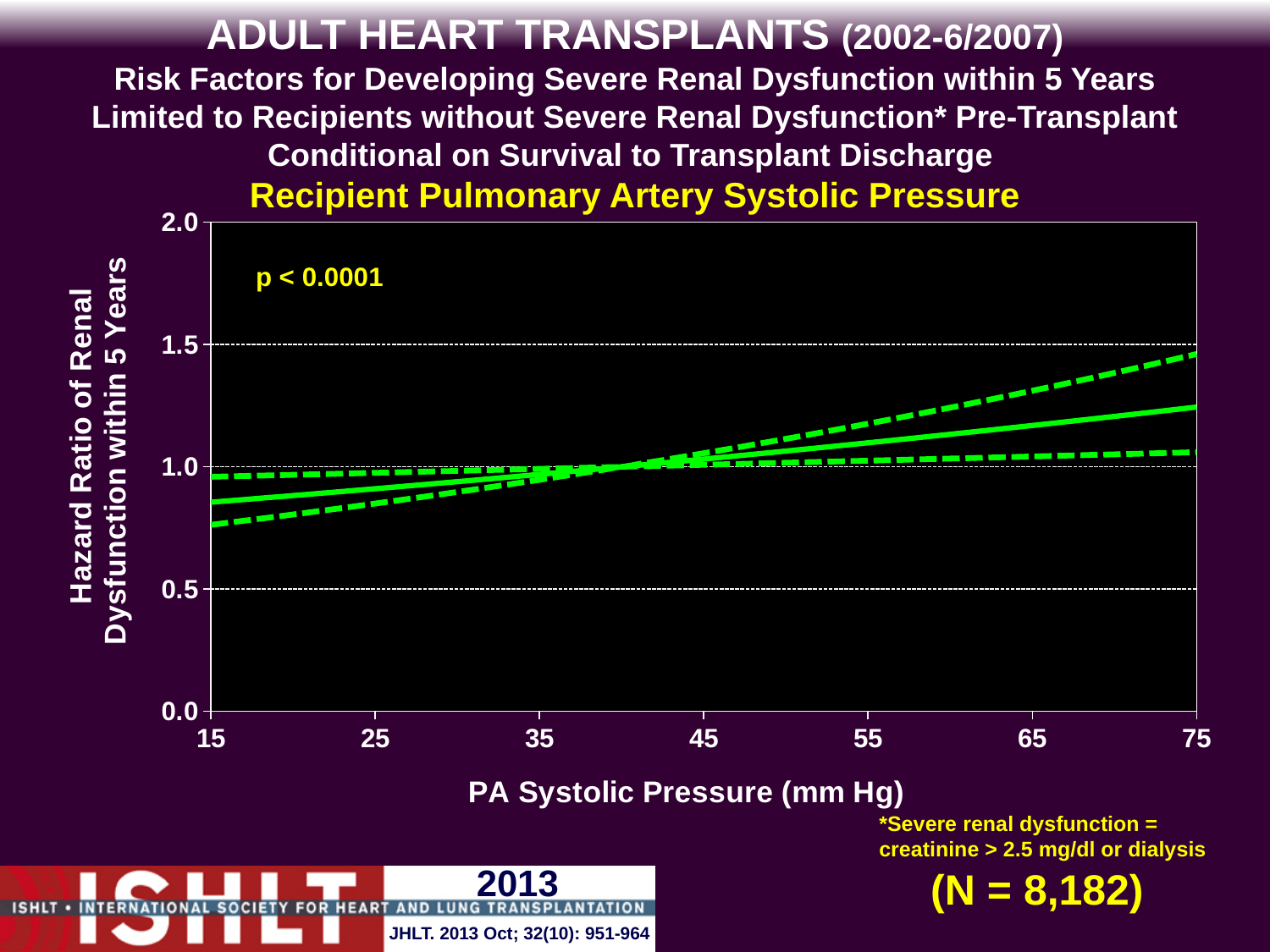
Is the upper dashed line at a PA systolic pressure of 75 mm Hg greater or less than 1.5? less Is the lower dashed line at a PA systolic pressure of 15 mm Hg greater or less than 0.5? greater Is the hazard ratio (solid line) higher at a PA systolic pressure of 75 mm Hg or at 15 mm Hg? 75 mm Hg What is the maximum value shown on the y axis? 2.0 Is the hazard ratio (solid line) at a PA systolic pressure of 15 mm Hg greater or less than 1.0? less Does the solid hazard ratio line rise or fall as PA systolic pressure increases from 15 to 75 mm Hg? rise What is the highest PA systolic pressure value shown on the x axis? 75 What is the label of the x axis? PA Systolic Pressure (mm Hg) What p-value is printed on the chart? p < 0.0001 How many lines are plotted on the chart? 3 What kind of chart is shown on the slide? line chart